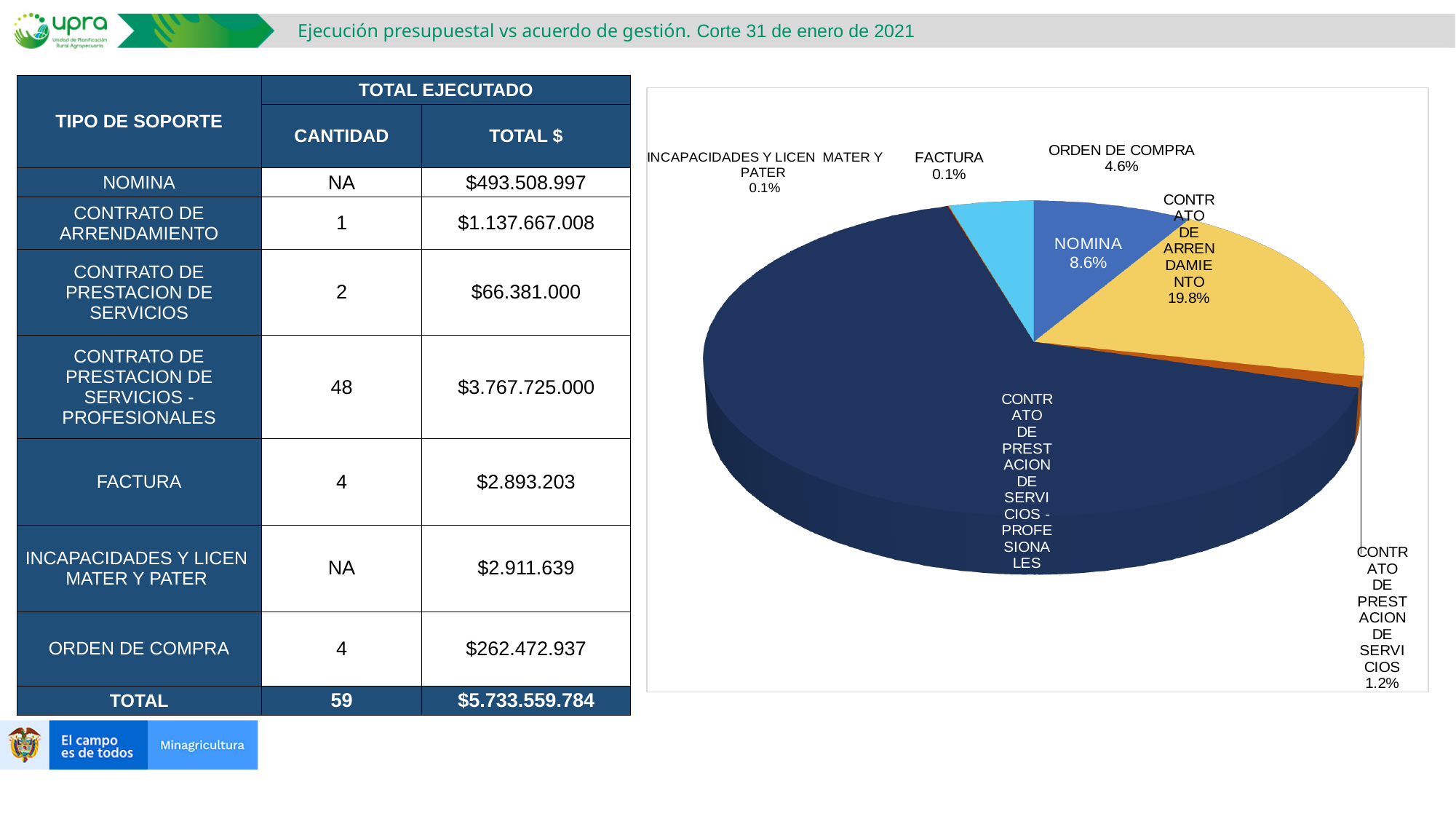
What share of the pie does ORDEN DE COMPRA represent? 4.6% What share of the pie does INCAPACIDADES Y LICEN MATER Y PATER represent? 0.1% What share of the pie does CONTRATO DE ARRENDAMIENTO represent? 19.8% How many slices does the pie chart have? 7 Which slice is larger, NOMINA or ORDEN DE COMPRA? NOMINA What kind of chart is shown on the slide? pie chart What is the difference in percentage points between the CONTRATO DE ARRENDAMIENTO slice and the NOMINA slice? 11.2 Which slice is larger, CONTRATO DE ARRENDAMIENTO or NOMINA? CONTRATO DE ARRENDAMIENTO Which category has the largest slice of the pie? CONTRATO DE PRESTACION DE SERVICIOS - PROFESIONALES